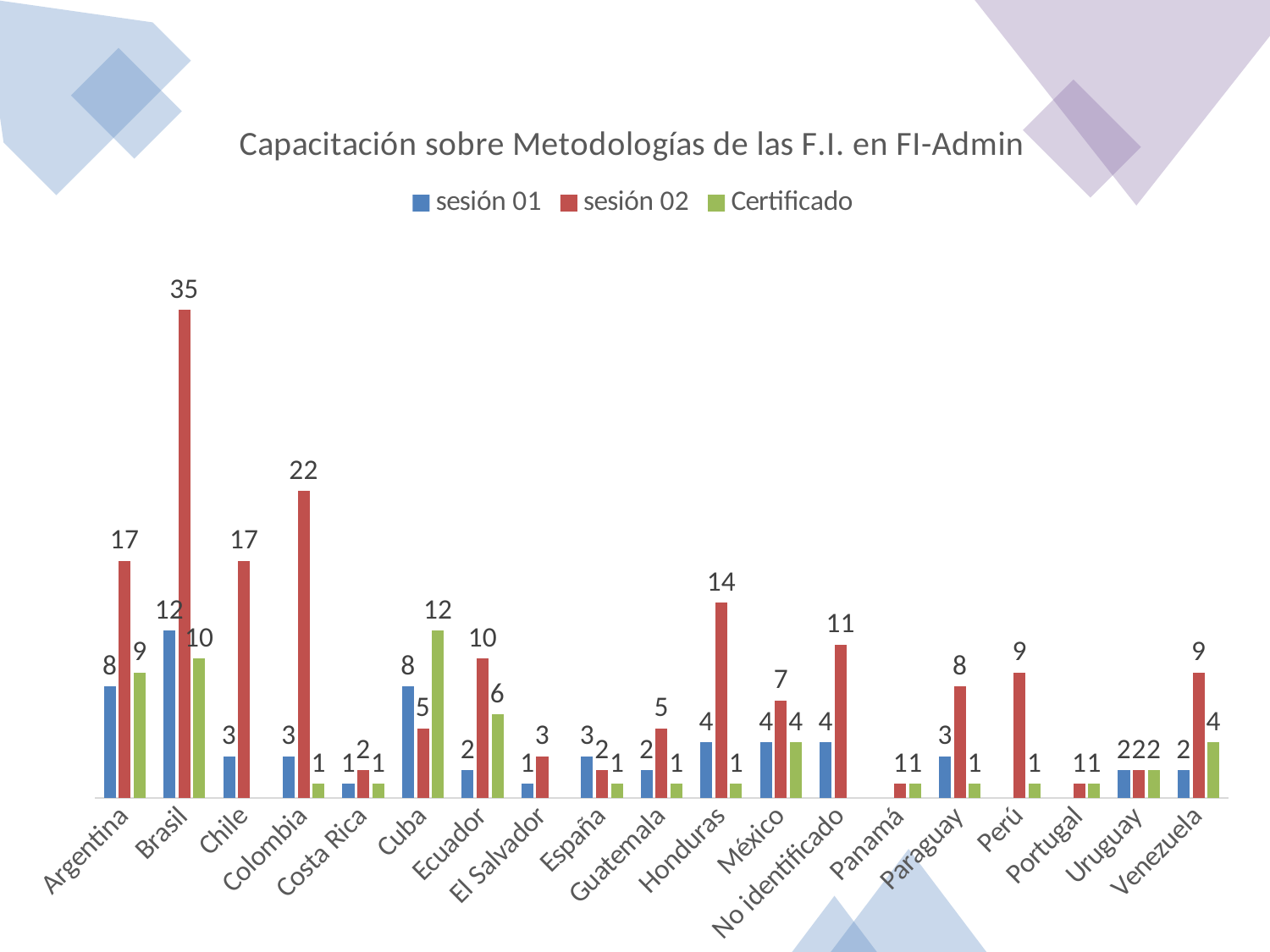
How many countries or categories are shown on the x axis? 19 Which is larger: the sesión 02 value for Ecuador or the sesión 02 value for Venezuela? Ecuador What is the sesión 02 value for Brasil? 35 How many series does the legend list? 3 Which is larger for Cuba: the sesión 01 value or the Certificado value? Certificado What is the difference between the sesión 02 values for Colombia and Chile? 5 What type of chart is shown on the slide? Bar chart What is the difference between the sesión 02 and sesión 01 values for Honduras? 10 What is the Certificado value for Cuba? 12 Which category has the highest Certificado value? Cuba What is the sesión 01 value for Argentina? 8 Which country has the highest sesión 02 value? Brasil